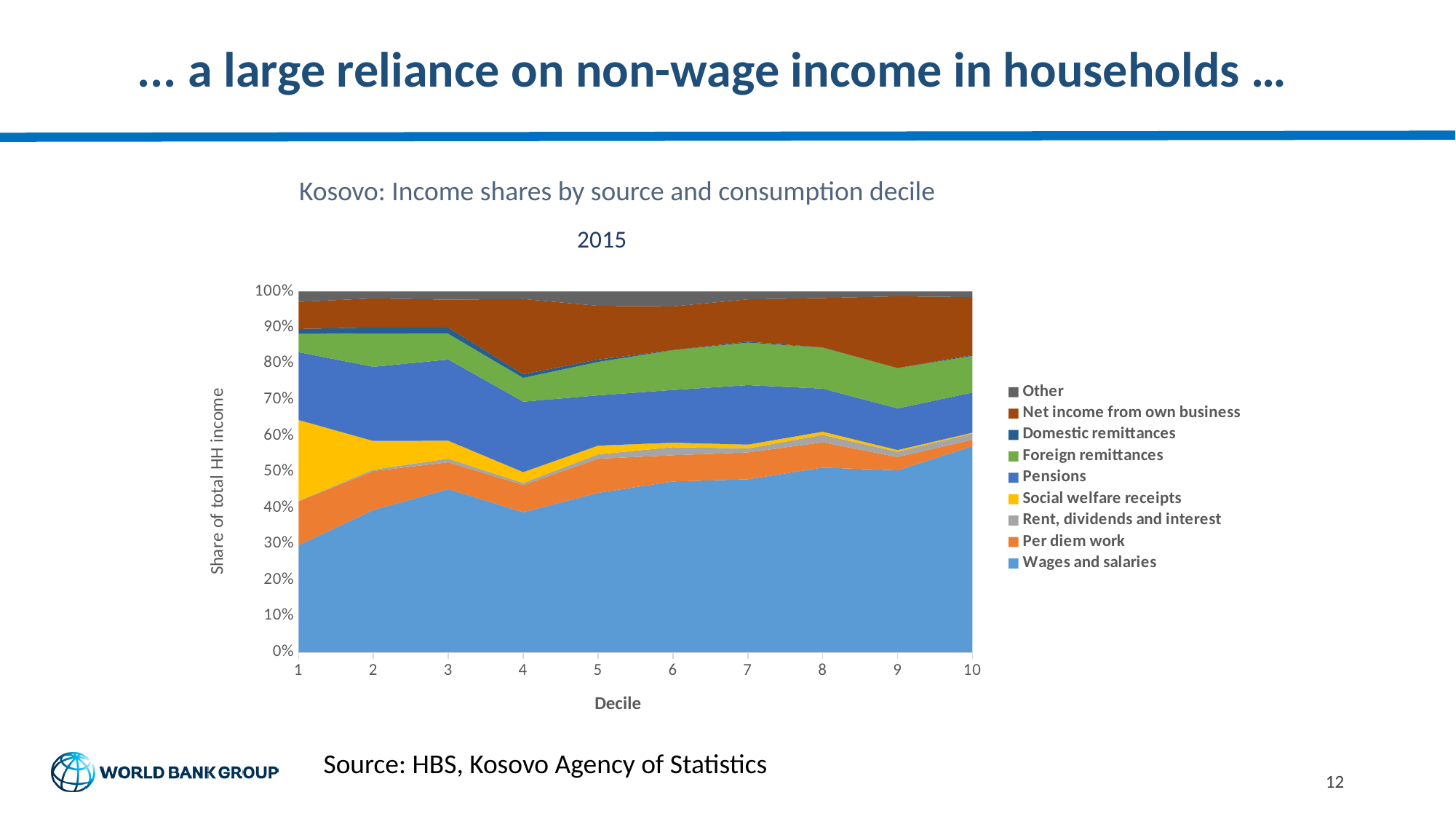
What is the title of the chart? Kosovo: Income shares by source and consumption decile In which decile is the share of Social welfare receipts largest? 1 Is the share of Wages and salaries for decile 5 greater or less than 50%? less Is the share of Wages and salaries for decile 1 greater or less than 40%? less Is the share of Social welfare receipts larger in decile 1 or decile 10? Decile 1 How many deciles are shown along the x axis of the chart? 10 What is the label of the y axis? Share of total HH income How many series does the chart's legend list? 9 Is the share of Wages and salaries for decile 10 greater or less than 50%? greater What kind of chart is shown on the slide? Stacked area chart Is the share of Wages and salaries larger in decile 1 or decile 10? Decile 10 Does the share of Wages and salaries generally rise or fall as the decile increases from 1 to 10? rise